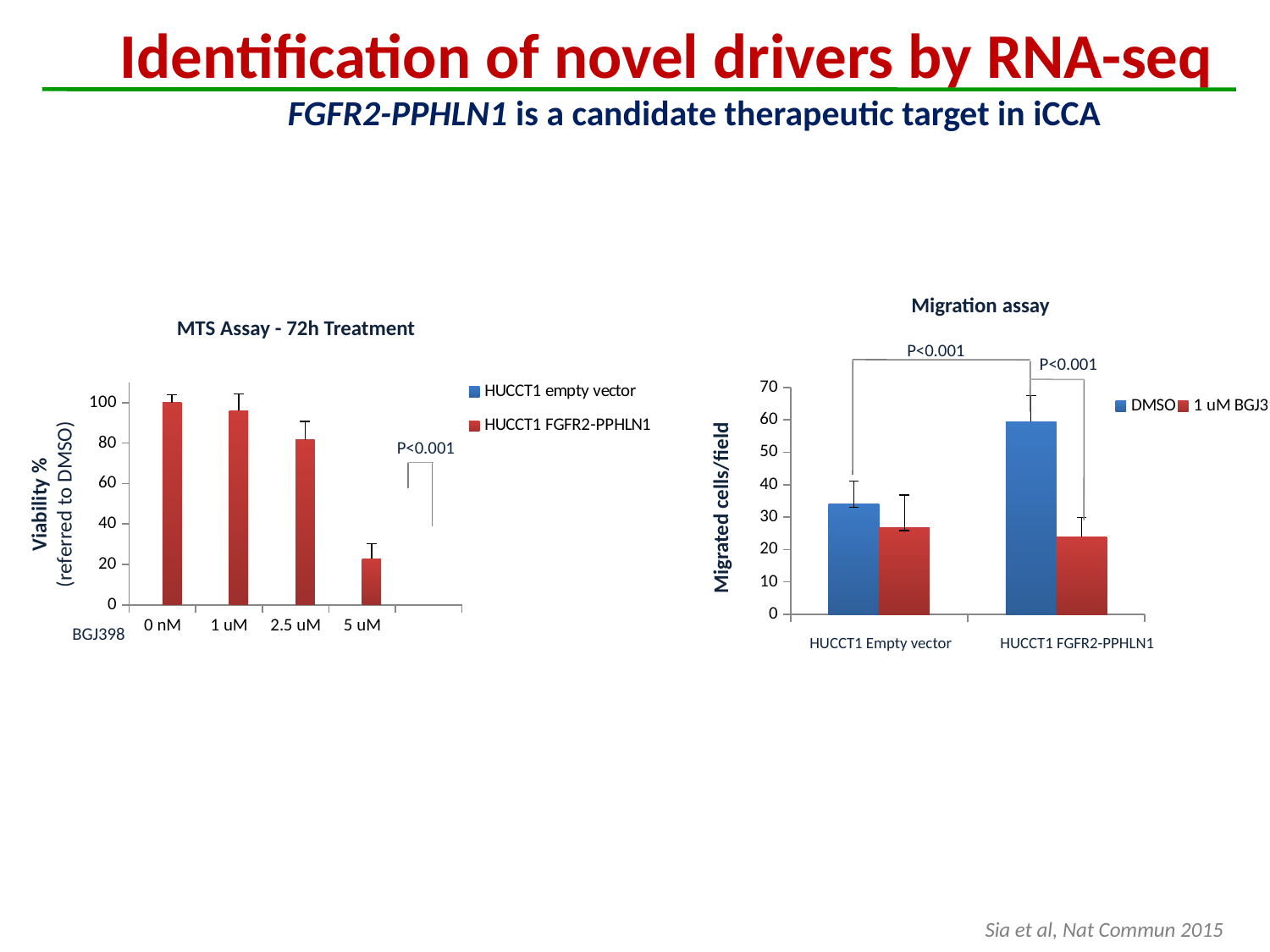
What is the y-axis title of the Migration assay chart? Migrated cells/field In the MTS Assay - 72h Treatment chart, is the viability at 5 uM greater or less than 40? less In the MTS Assay - 72h Treatment chart, which BGJ398 concentration has the lowest viability? 5 uM How many series does the legend of the Migration assay chart list? 2 In the MTS Assay - 72h Treatment chart, do the viability values rise or fall as the BGJ398 concentration increases? fall In the Migration assay chart, for HUCCT1 FGFR2-PPHLN1, is the DMSO value greater or less than 50? greater What kind of chart is the MTS Assay - 72h Treatment chart? bar chart In the MTS Assay - 72h Treatment chart, is the viability at 2.5 uM greater or less than 60? greater How many BGJ398 concentrations are shown on the x axis of the MTS Assay - 72h Treatment chart? 4 What kind of chart is the Migration assay chart? bar chart How many series does the legend of the MTS Assay - 72h Treatment chart list? 2 In the Migration assay chart, which bar is the highest? DMSO for HUCCT1 FGFR2-PPHLN1